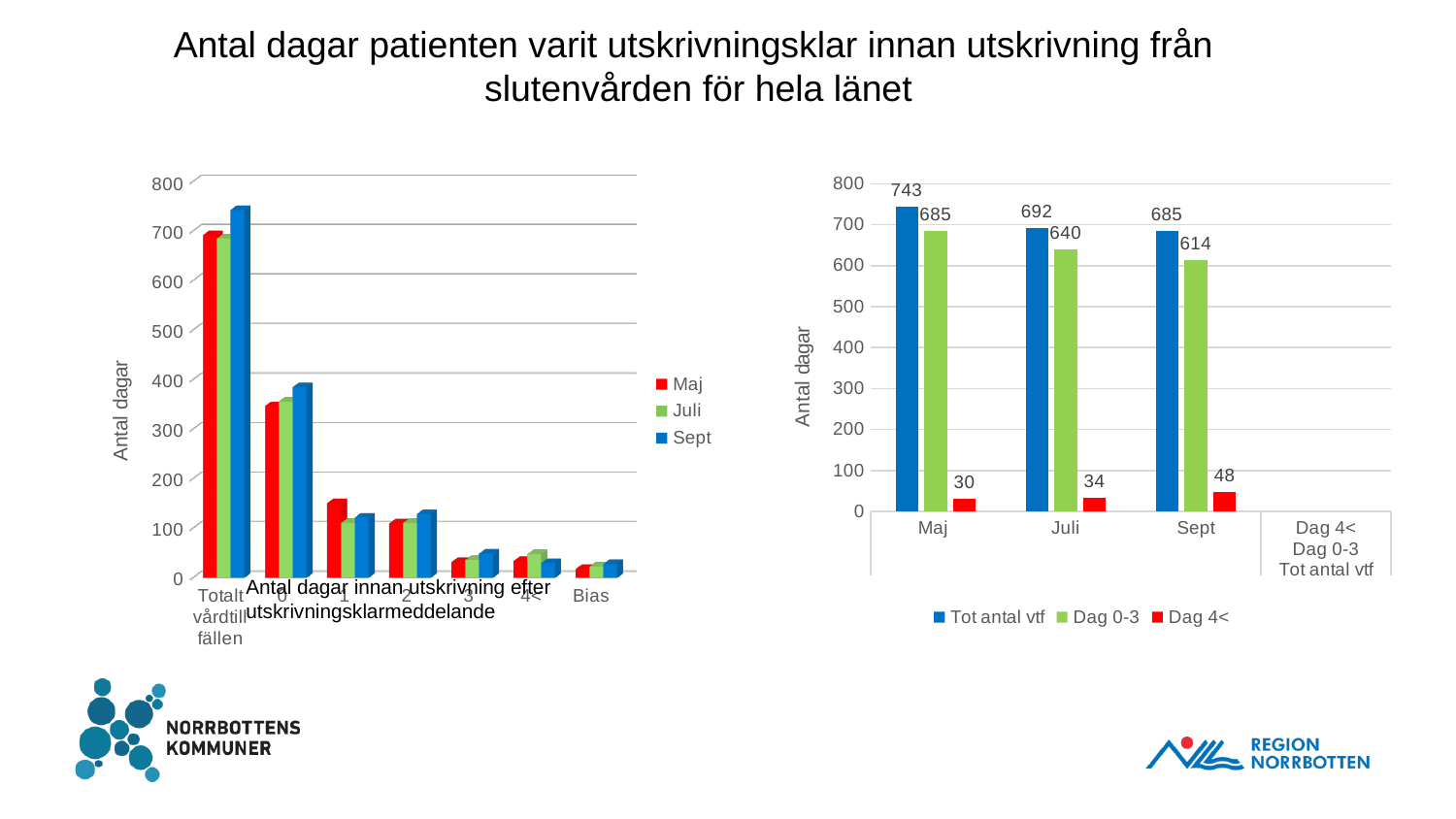
In the right chart, what is the difference between Tot antal vtf and Dag 0-3 for Sept? 71 In the left chart, how many series does the legend list? 3 In the right chart, is the Dag 0-3 value for Maj larger or smaller than the Dag 0-3 value for Sept? larger In the right chart, how many series does the legend list? 3 What kind of chart is the left chart? bar chart In the left chart, is the Sept value for Totalt vårdtillfällen greater or less than 700? greater In the right chart, which month has the highest Tot antal vtf value? Maj In the right chart, which month has the lowest Dag 4< value? Maj In the right chart, what is the value of Dag 4< for Sept? 48 In the right chart, what is the value of Tot antal vtf for Maj? 743 In the right chart, does the Dag 4< value rise or fall from Maj to Sept? rise In the right chart, what is the value of Dag 0-3 for Juli? 640